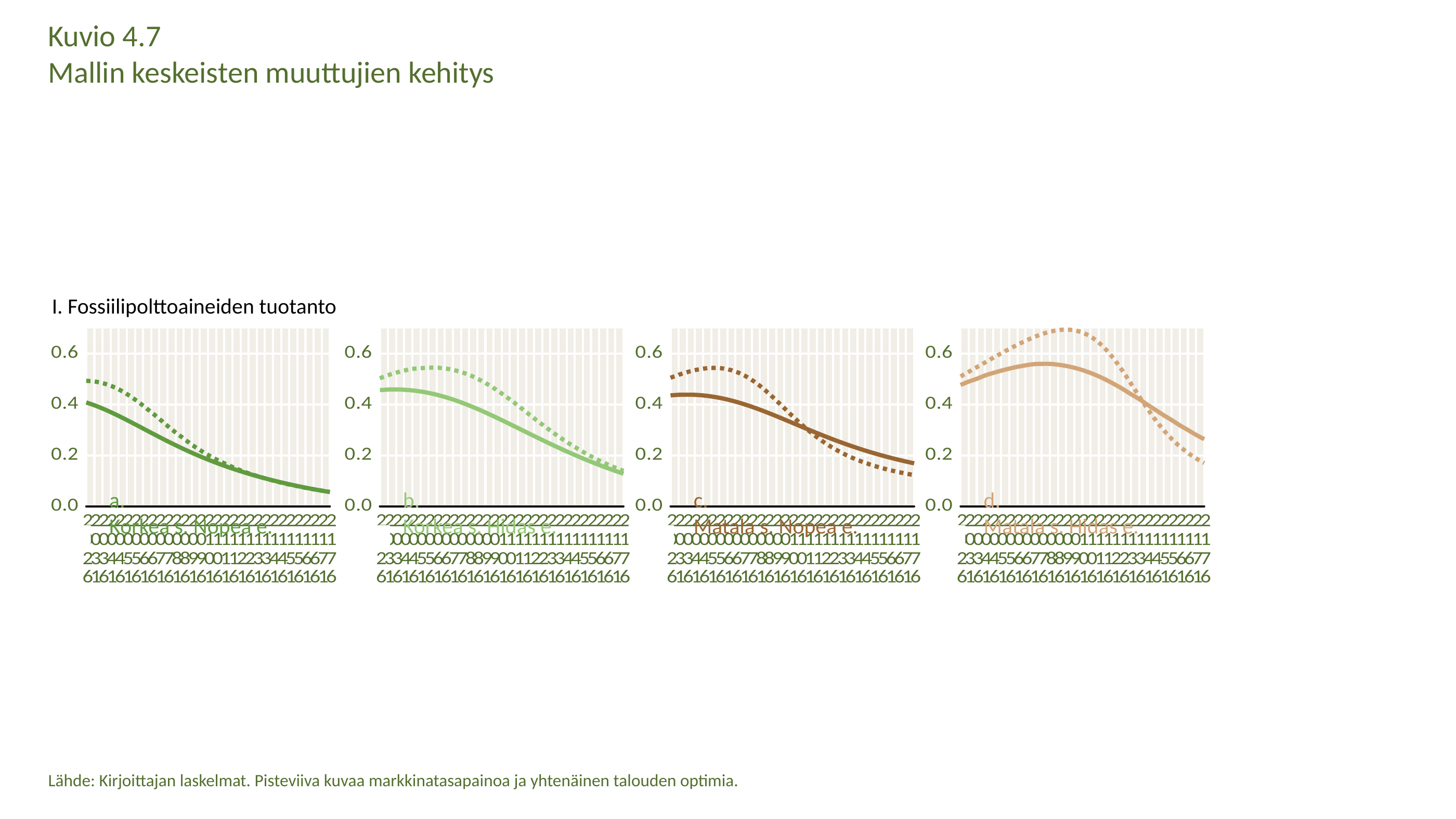
In chart d. (Matala s. Hidas e.), is the peak value of the solid line greater or less than 0.6? less How many charts are shown under the heading 'I. Fossiilipolttoaineiden tuotanto'? 4 In chart c. (Matala s. Nopea e.), which line has the higher value at the right end of the x axis, the dotted line or the solid line? the solid line What is the title of chart c.? Matala s. Nopea e. In chart a. (Korkea s. Nopea e.), is the value of the solid line at the right end of the x axis greater or less than 0.2? less In chart b. (Korkea s. Hidas e.), is the highest value of the dotted line greater or less than 0.4? greater In chart a. (Korkea s. Nopea e.), do the values of the solid line rise or fall along the x axis? fall How many lines are plotted in chart d. (Matala s. Hidas e.)? 2 According to the footnote, what does the dotted line represent? markkinatasapainoa (market equilibrium) In chart a. (Korkea s. Nopea e.), which line has the higher value at the left end of the x axis, the dotted line or the solid line? the dotted line What kind of chart is chart a. (Korkea s. Nopea e.)? line chart